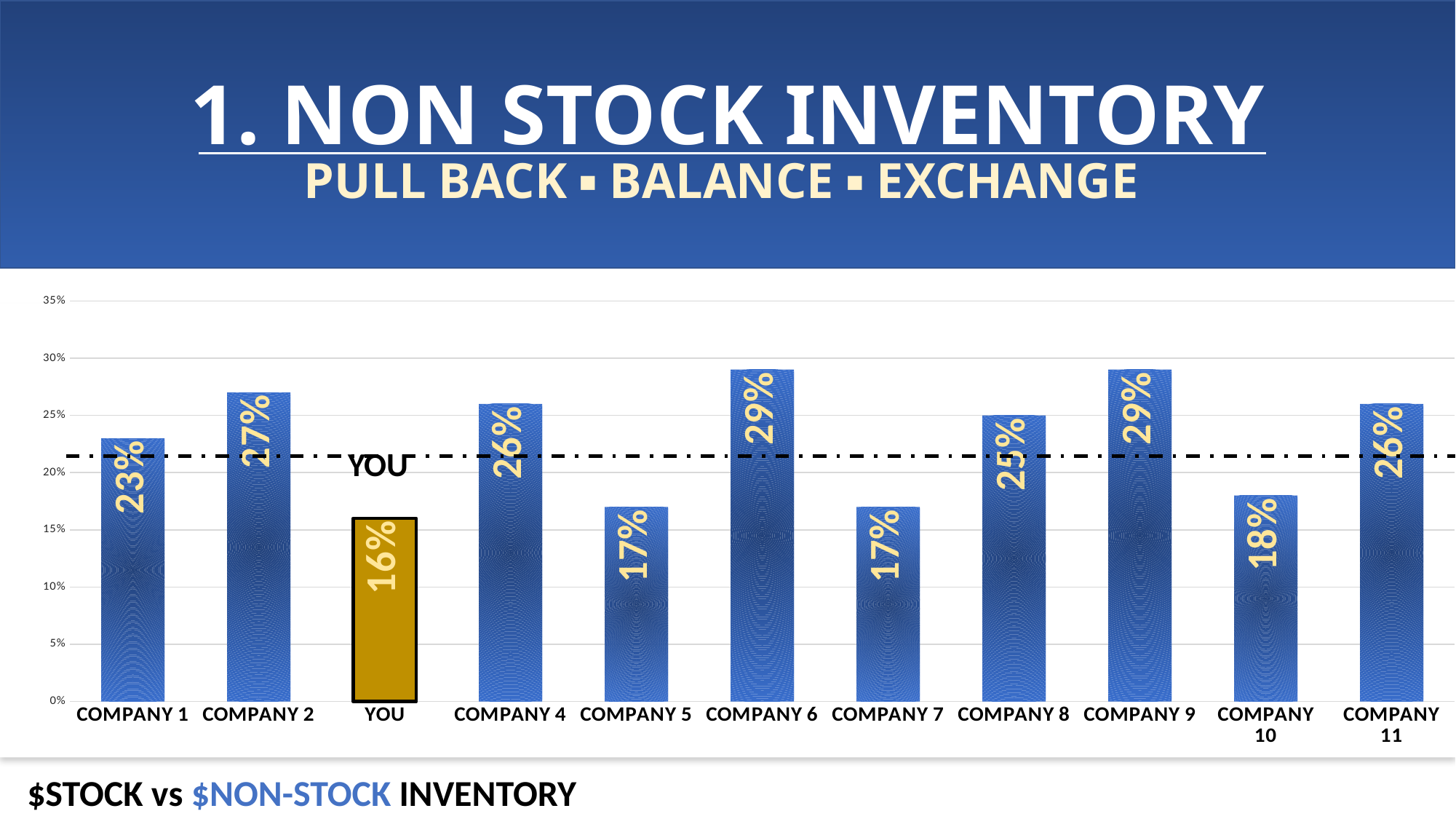
What is the value for Company 1? 23% Which is larger, Company 4 or Company 10? Company 4 Which category has the lowest value? YOU What is the value for YOU? 16% Which categories share the highest value? Company 6 and Company 9 How many categories are shown on the x axis? 11 What is the value for Company 10? 18% What kind of chart is this? Bar chart What is the difference between Company 9 and Company 5? 12% What is the value for Company 8? 25% What is the difference between Company 2 and YOU? 11% Which bar is coloured gold instead of blue? YOU